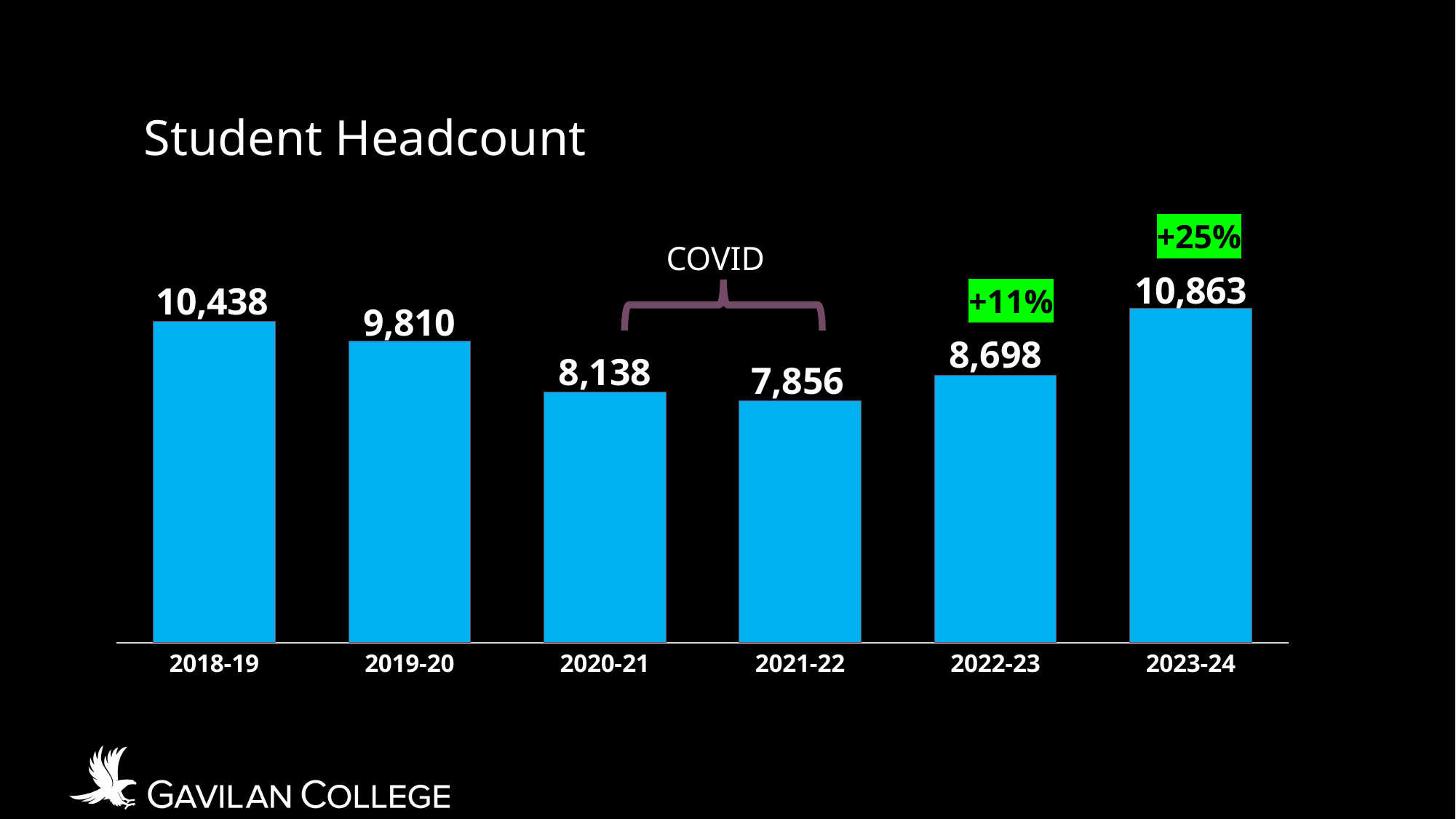
Which year has the highest student headcount? 2023-24 What is the student headcount for 2022-23? 8,698 Which year has a larger headcount, 2020-21 or 2021-22? 2020-21 Which year has the lowest student headcount? 2021-22 What is the difference in headcount between 2018-19 and 2019-20? 628 What is the student headcount for 2018-19? 10,438 What percentage change is labelled above the 2023-24 bar? +25% What is the difference in headcount between 2023-24 and 2022-23? 2,165 What kind of chart is shown on the slide? Bar chart Does the headcount rise or fall from 2021-22 to 2023-24? Rise How many academic years are shown in the chart? 6 What is the student headcount for 2021-22? 7,856